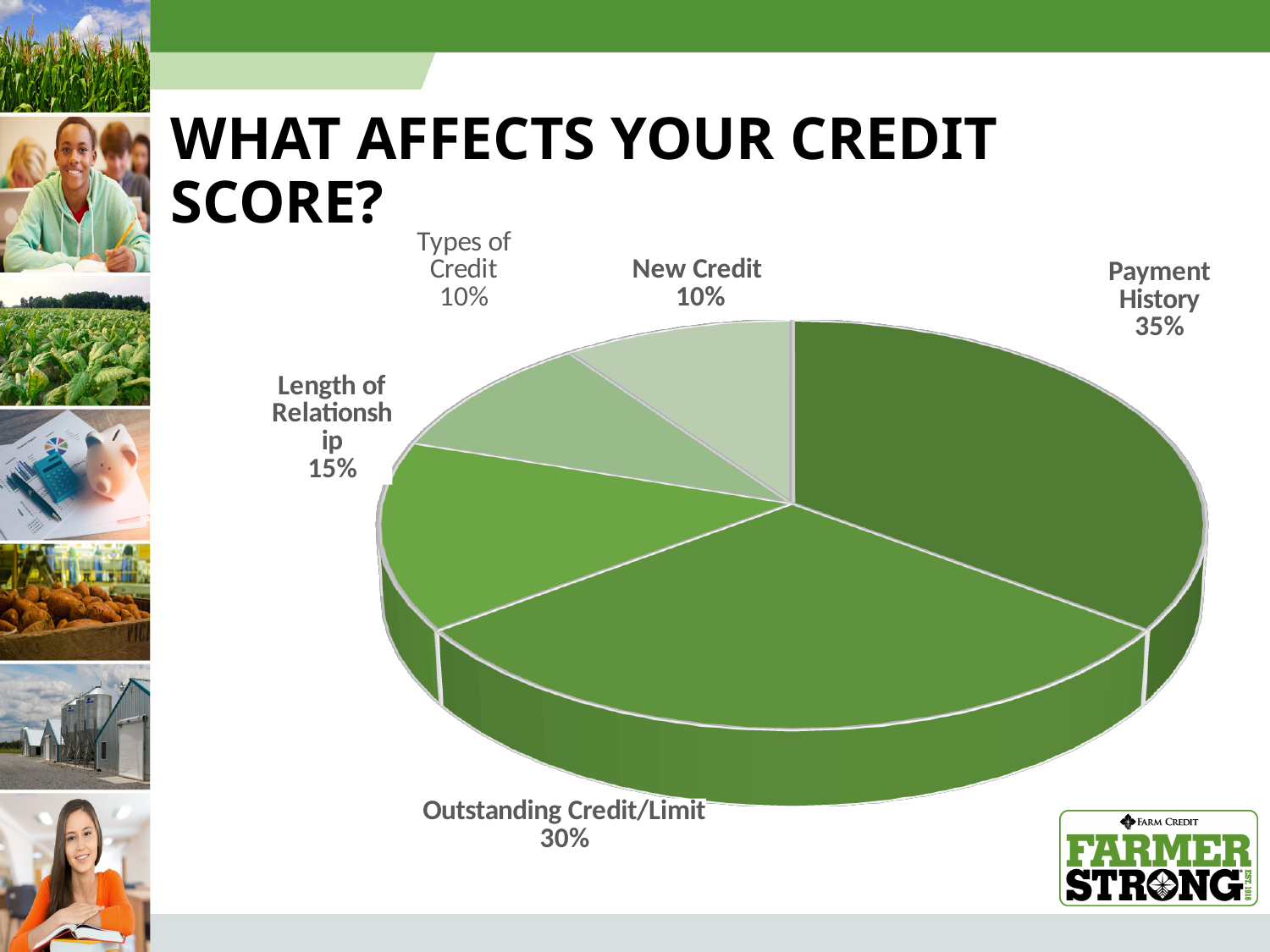
What percentage of the credit score is attributed to Payment History? 35% What kind of chart is shown on the slide? Pie chart What percentage is shown for New Credit? 10% What is the title of the slide containing the chart? WHAT AFFECTS YOUR CREDIT SCORE? What is the difference between Outstanding Credit/Limit and Length of Relationship? 15% How many slices does the pie chart have? 5 What is the difference in percentage points between Payment History and Outstanding Credit/Limit? 5 Which factor has the largest share of the pie? Payment History What percentage does Outstanding Credit/Limit account for? 30% What is the value shown for Length of Relationship? 15% What is the combined share of New Credit and Types of Credit? 20% Which is larger, Length of Relationship or Types of Credit? Length of Relationship